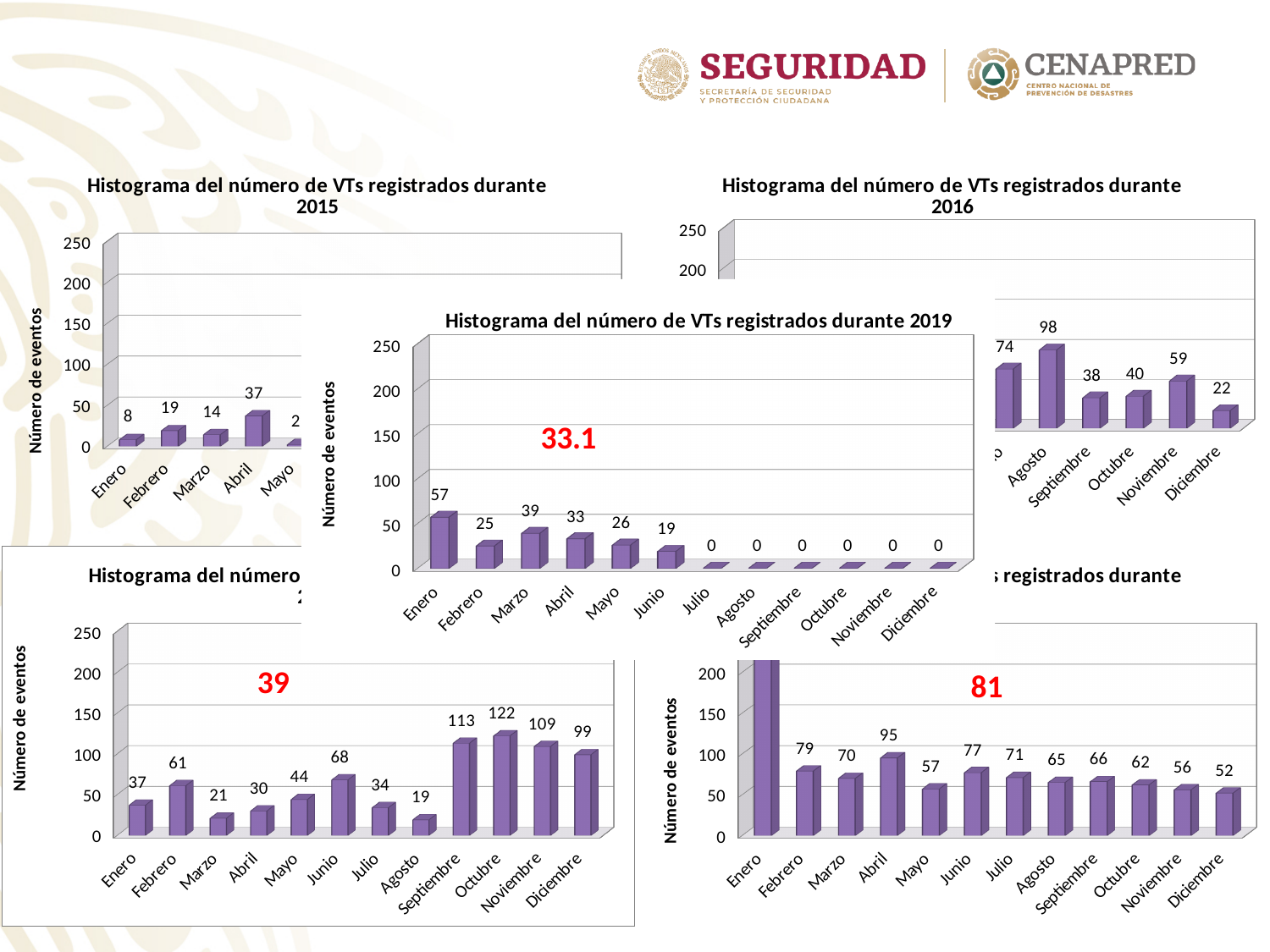
In the chart titled 'Histograma del número de VTs registrados durante 2019', what is the difference between the values for Marzo and Junio? 20 In the chart titled 'Histograma del número de VTs registrados durante 2015', which is larger, the value for Febrero or the value for Marzo? Febrero In the chart titled 'Histograma del número de VTs registrados durante 2019', which month has the highest value? Enero In the bottom-right chart, what is the value for Abril? 95 In the chart titled 'Histograma del número de VTs registrados durante 2019', how many months show a value of 0? 6 In the chart titled 'Histograma del número de VTs registrados durante 2016', what is the value for Agosto? 98 In the bottom-right chart, is the value for Enero greater or less than 200? greater In the bottom-left chart, what is the value for Septiembre? 113 In the chart titled 'Histograma del número de VTs registrados durante 2015', what is the value for Abril? 37 In the bottom-left chart, which month has the highest value? Octubre In the chart titled 'Histograma del número de VTs registrados durante 2016', what is the difference between the values for Noviembre and Diciembre? 37 In the chart titled 'Histograma del número de VTs registrados durante 2019', what is the value for Enero? 57